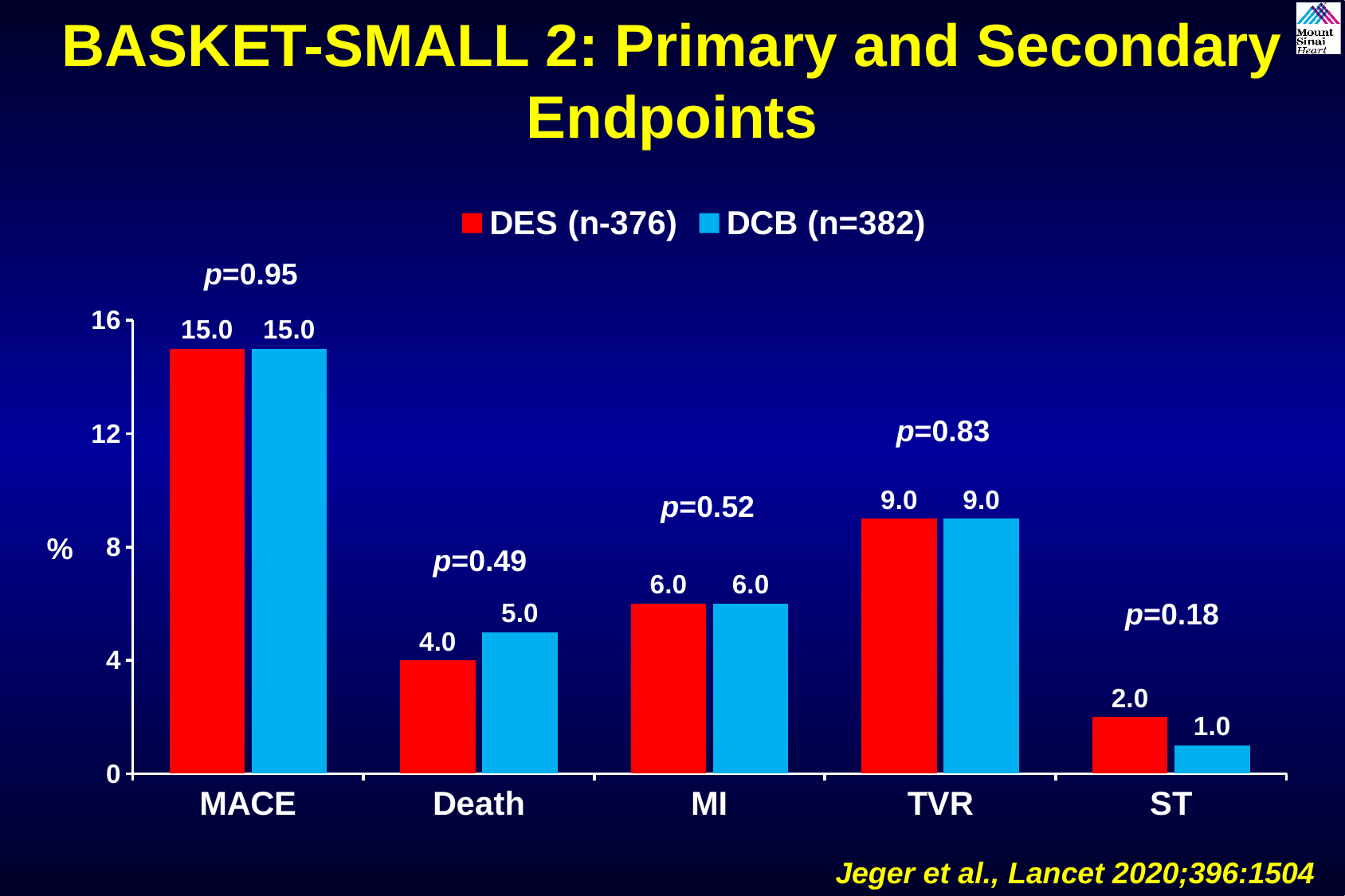
What is the value for DCB in the Death category? 5.0 How many series does the legend list? 2 What is the value for DES in the ST category? 2.0 Which category has the lowest value for the DCB series? ST Which category has the highest value for the DES series? MACE What p-value is shown above the MI bars? p=0.52 What is the value for DES in the MACE category? 15.0 What is the value for DCB in the TVR category? 9.0 In the ST category, which series has the larger value, DES or DCB? DES What is the difference between the DCB and DES values in the Death category? 1.0 How many categories are shown on the x axis? 5 What kind of chart is shown on the slide? Bar chart